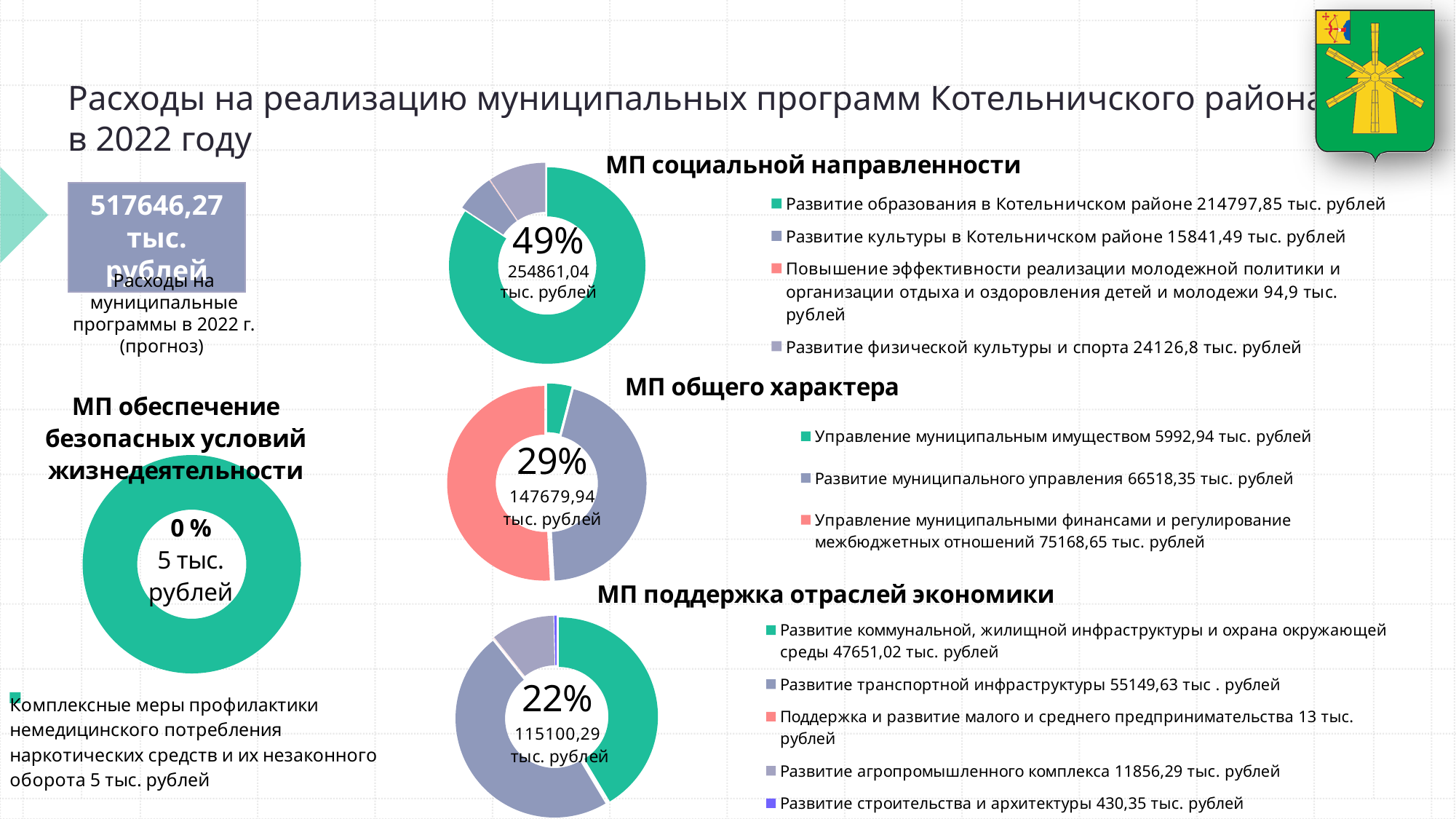
In the "МП социальной направленности" chart, what is the value for "Развитие образования в Котельничском районе"? 214797,85 тыс. рублей In the "МП поддержка отраслей экономики" chart, what is the difference between "Развитие транспортной инфраструктуры" and "Развитие коммунальной, жилищной инфраструктуры и охрана окружающей среды"? 7498,61 тыс. рублей What share of total expenditure is shown in the centre of the "МП общего характера" chart? 29% What total amount is shown in the centre of the "МП поддержка отраслей экономики" chart? 115100,29 тыс. рублей In the "МП поддержка отраслей экономики" chart, which is larger: "Развитие транспортной инфраструктуры" or "Развитие коммунальной, жилищной инфраструктуры и охрана окружающей среды"? Развитие транспортной инфраструктуры What kind of chart is used for "МП социальной направленности"? Donut (pie) chart In the "МП социальной направленности" chart, what is the difference between "Развитие физической культуры и спорта" and "Развитие культуры в Котельничском районе"? 8285,31 тыс. рублей How many programs does the legend of the "МП поддержка отраслей экономики" chart list? 5 In the "МП общего характера" chart, which program has the largest value? Управление муниципальными финансами и регулирование межбюджетных отношений In the "МП общего характера" chart, what is the value for "Развитие муниципального управления"? 66518,35 тыс. рублей In the "МП социальной направленности" chart, which program has the smallest value? Повышение эффективности реализации молодежной политики и организации отдыха и оздоровления детей и молодежи What amount is shown in the centre of the "МП обеспечение безопасных условий жизнедеятельности" chart? 5 тыс. рублей